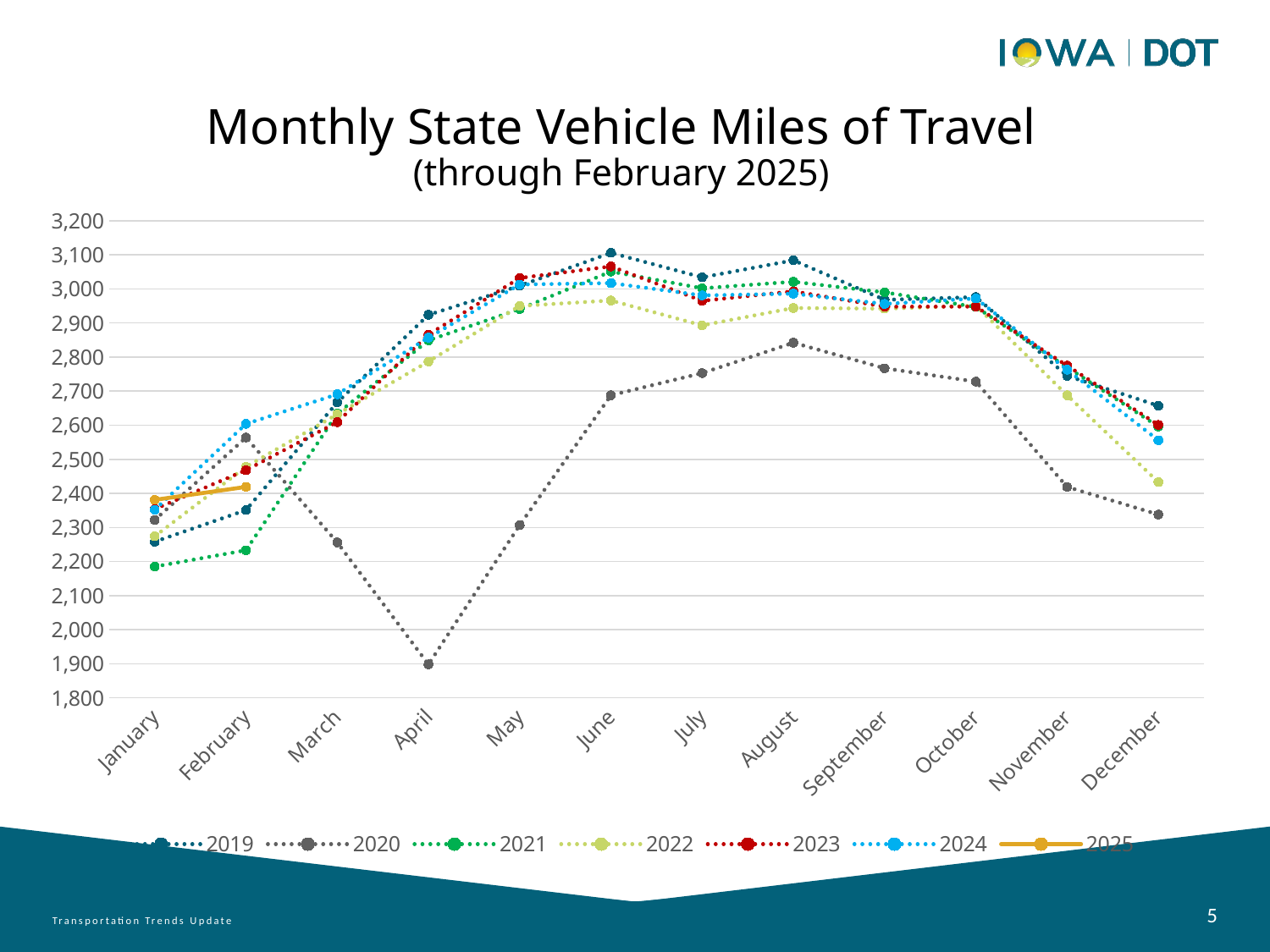
Does the 2020 line rise or fall from March to April? Fall Which is larger, the August value for 2019 or the August value for 2020? 2019 Which year has the lowest value in April? 2020 Is the value for 2020 in April greater or less than 2,000? less Through which month does the 2025 series have data points? February Is the value for 2019 in June greater or less than 3,000? greater How many series does the legend list? 7 Is the value for 2020 in December greater or less than 2,400? less What is the title of the chart? Monthly State Vehicle Miles of Travel (through February 2025) How many months are shown along the x axis? 12 What kind of chart is shown on the slide? Line chart